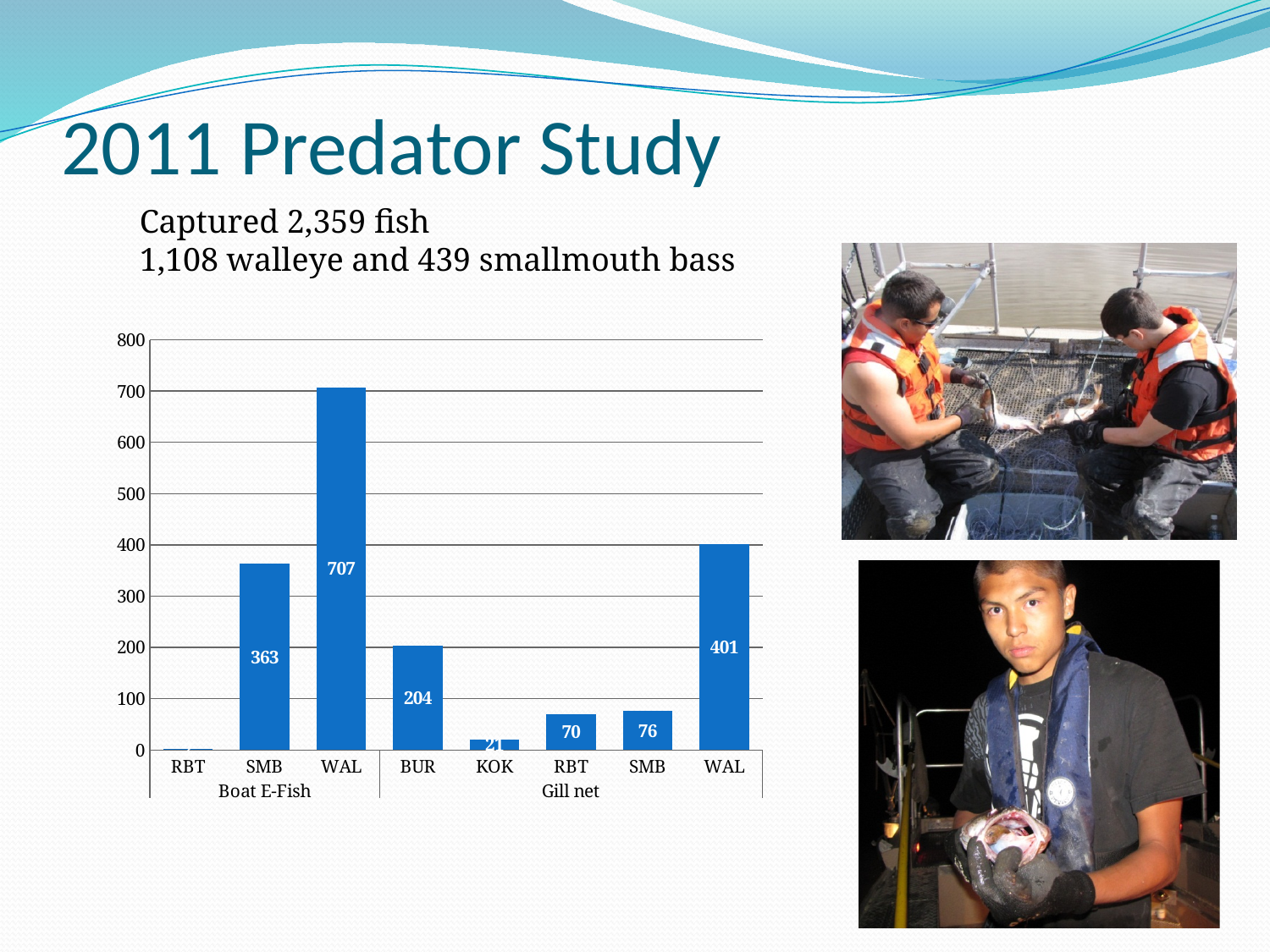
What is the value for BUR under Gill net? 204 What kind of chart is shown on the slide? Bar chart What is the value for WAL under Boat E-Fish? 707 What is the value for RBT under Gill net? 70 How many bars are plotted in the chart? 8 What is the difference between WAL and SMB under Boat E-Fish? 344 What is the value for SMB under Boat E-Fish? 363 What is the value for WAL under Gill net? 401 What is the difference between WAL and SMB under Gill net? 325 Is the value for SMB under Boat E-Fish greater or less than 300? greater Which is larger: BUR under Gill net or SMB under Boat E-Fish? SMB under Boat E-Fish Which bar has the highest value in the chart? WAL (Boat E-Fish)